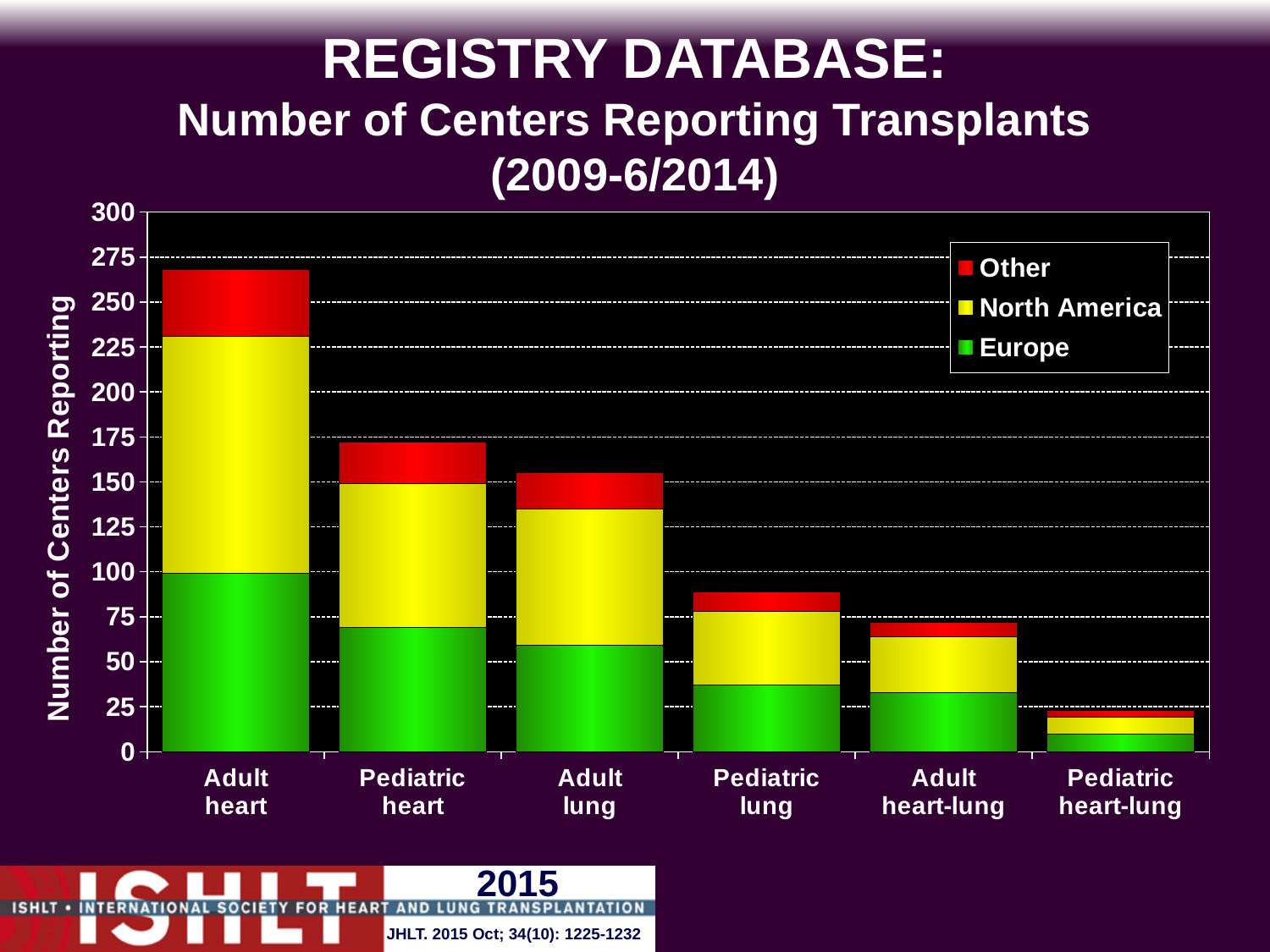
Which has a larger total number of centers reporting, Adult lung or Adult heart-lung? Adult lung Which colour represents North America in the chart? yellow How many series does the legend list? 3 Do the total numbers of centers reporting rise or fall moving from left to right along the x axis? fall What kind of chart is shown on the slide? stacked bar chart Which category has the lowest total number of centers reporting? Pediatric heart-lung How many transplant categories are shown along the x axis? 6 Is the total number of centers reporting for Pediatric heart greater or less than 150? greater Is the total number of centers reporting for Pediatric lung greater or less than 100? less Is the total number of centers reporting for Adult heart greater or less than 250? greater Which category has the highest total number of centers reporting? Adult heart